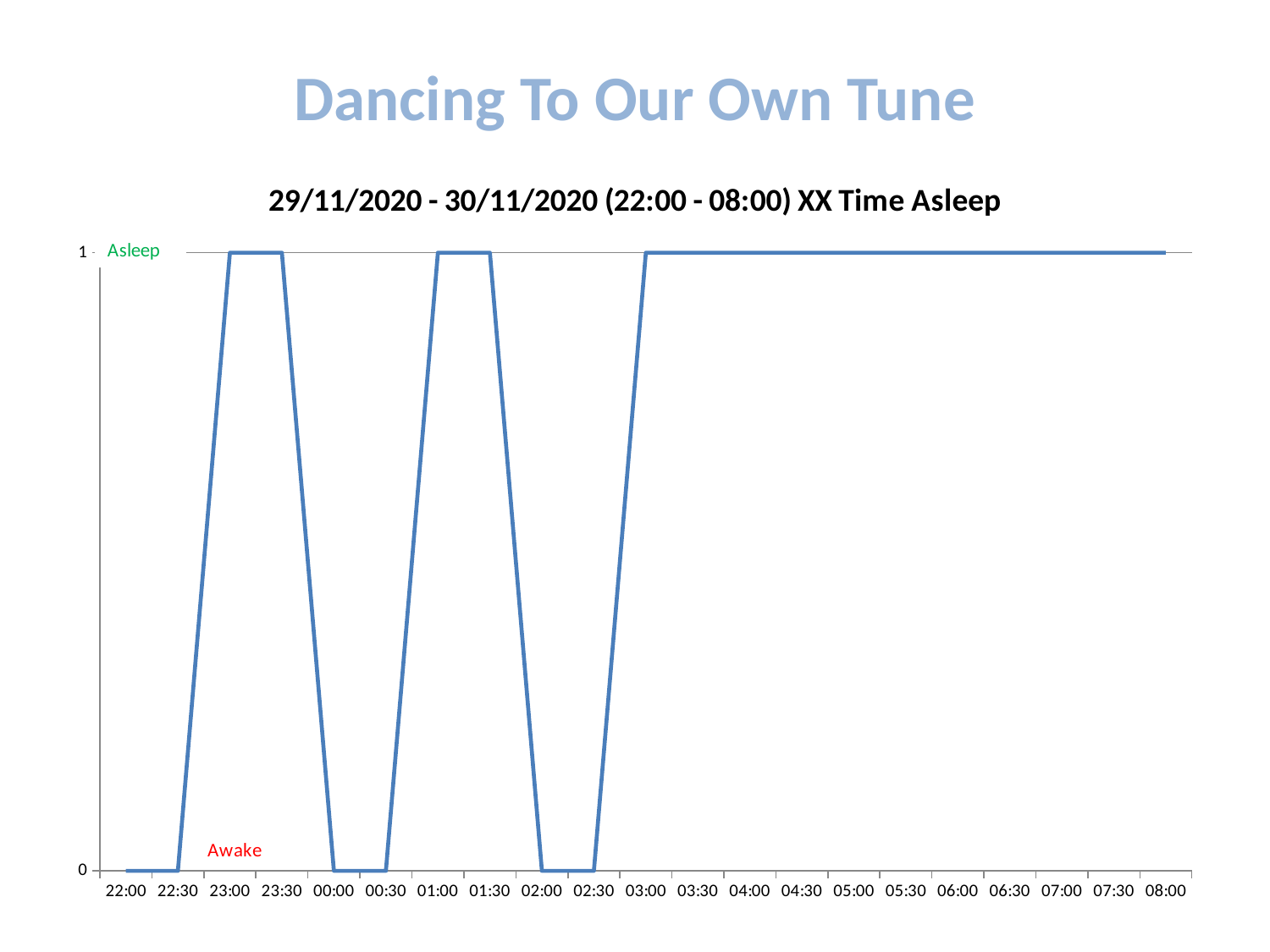
What is the difference between the value at 03:00 and the value at 02:30? 1 What is the value at 01:30? 1 What is the value at 02:00? 0 Which is larger, the value at 23:30 or the value at 00:00? 23:30 What is the value at 05:00? 1 What kind of chart is shown on the slide? line chart What label is shown in green next to the value 1 on the y axis? Asleep What is the value at 23:00? 1 How many time labels are shown on the x axis? 21 What is the value at 00:30? 0 What is the title of the chart? 29/11/2020 - 30/11/2020 (22:00 - 08:00) XX Time Asleep What is the value at 22:00? 0